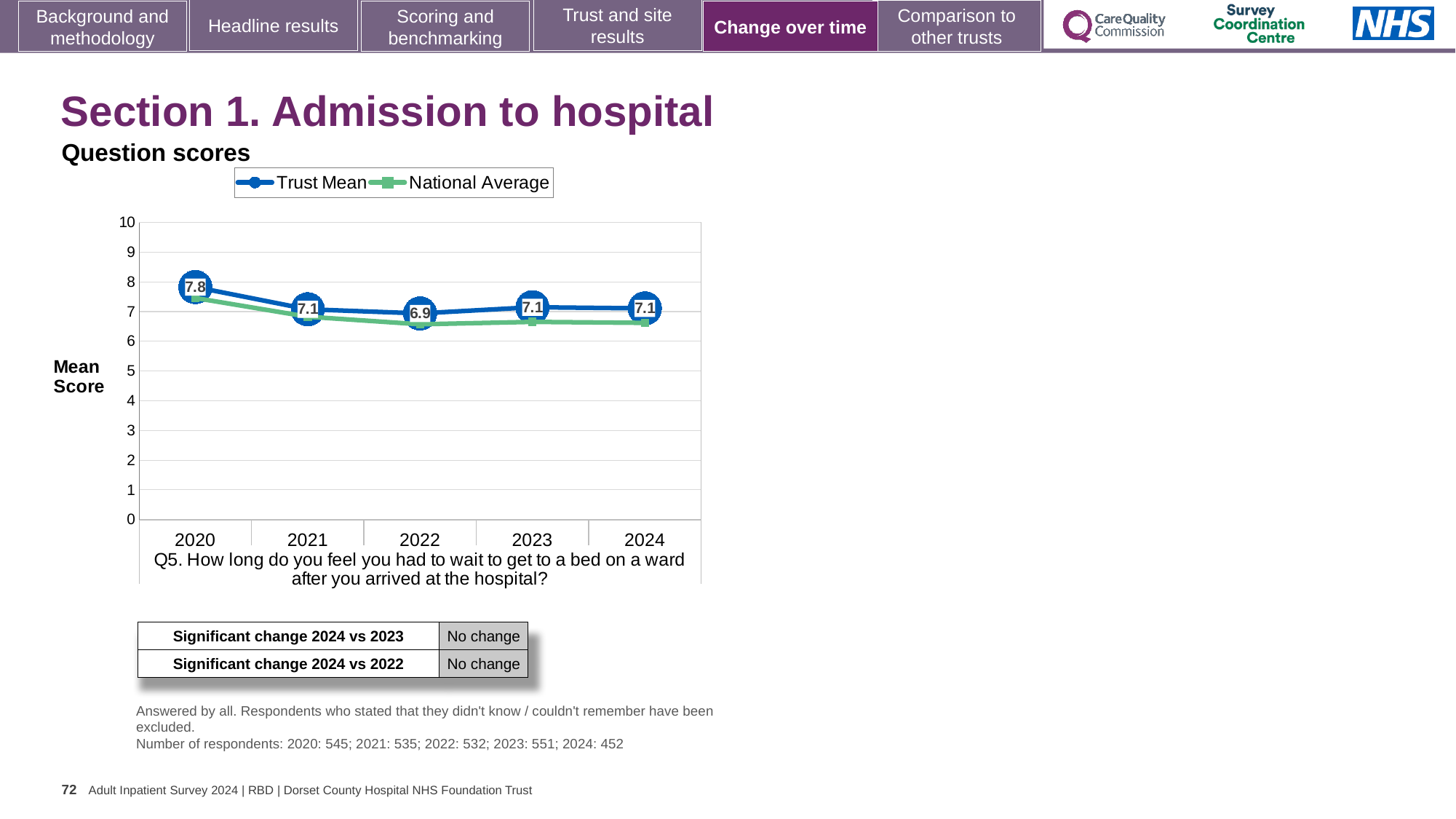
Which is larger, the Trust Mean score in 2020 or in 2023? 2020 What is the difference between the Trust Mean score in 2020 and in 2021? 0.7 What is the Trust Mean score for 2020? 7.8 How many series does the legend list? 2 What is the Trust Mean score for 2022? 6.9 In which year is the Trust Mean score lowest? 2022 What is the Trust Mean score for 2024? 7.1 What kind of chart is shown on the slide? line chart Does the Trust Mean score rise or fall from 2020 to 2022? fall Is the National Average value for 2022 greater or less than 7? less In which year is the Trust Mean score highest? 2020 How many years are shown on the x axis of the chart? 5